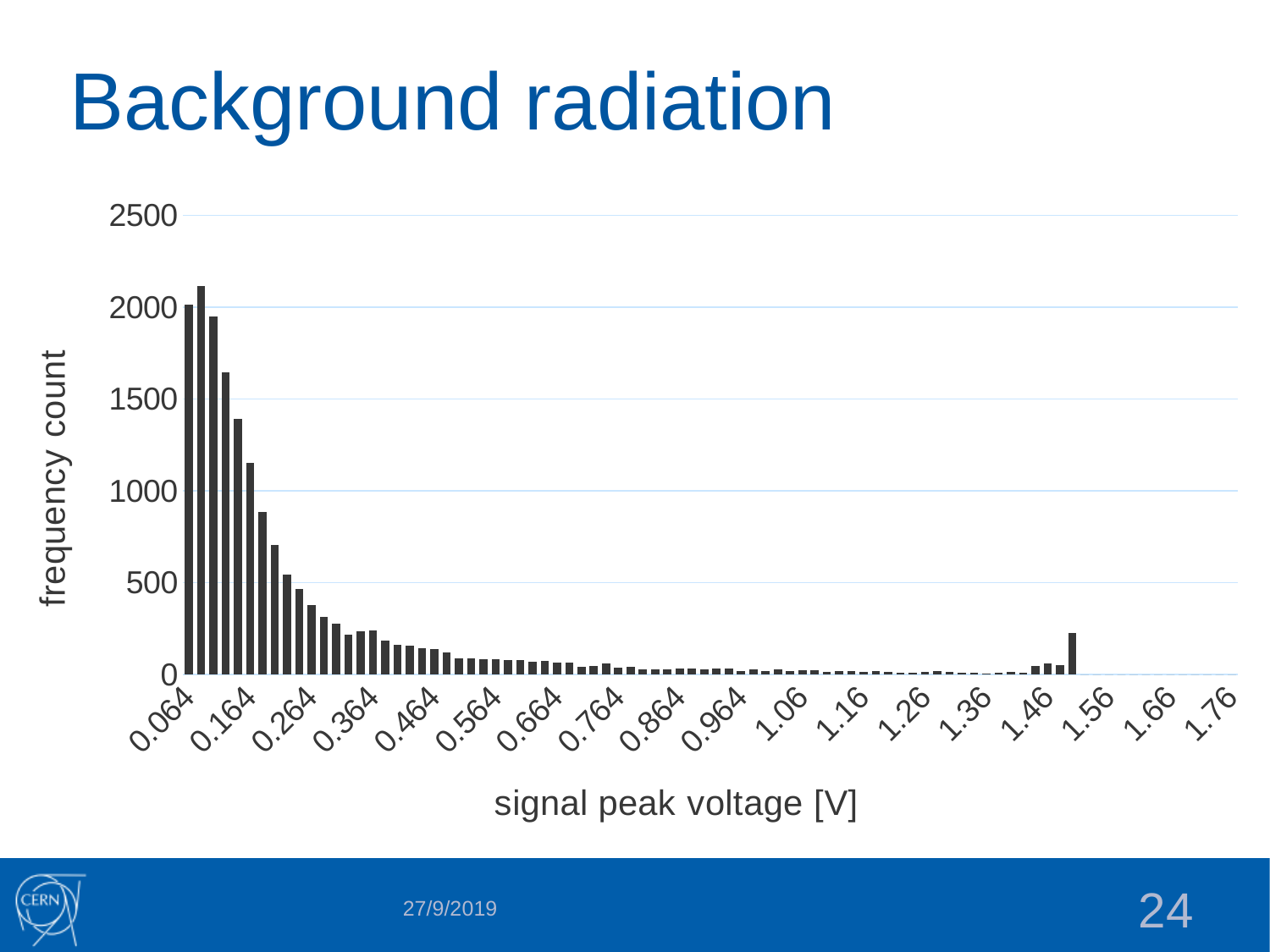
Is the frequency count for 1.56 greater or less than 500? less Which has the larger frequency count, 0.164 or 1.06? 0.164 Is the frequency count for 0.164 greater or less than 1000? greater Which has the larger frequency count, 0.464 or 0.964? 0.464 Which has the larger frequency count, 0.064 or 0.264? 0.064 Do the frequency counts generally rise or fall as signal peak voltage increases along the x axis? fall Is the frequency count for 0.264 greater or less than 500? less What kind of chart is shown on the slide? bar chart What is the label of the x axis? signal peak voltage [V] What is the label of the y axis? frequency count